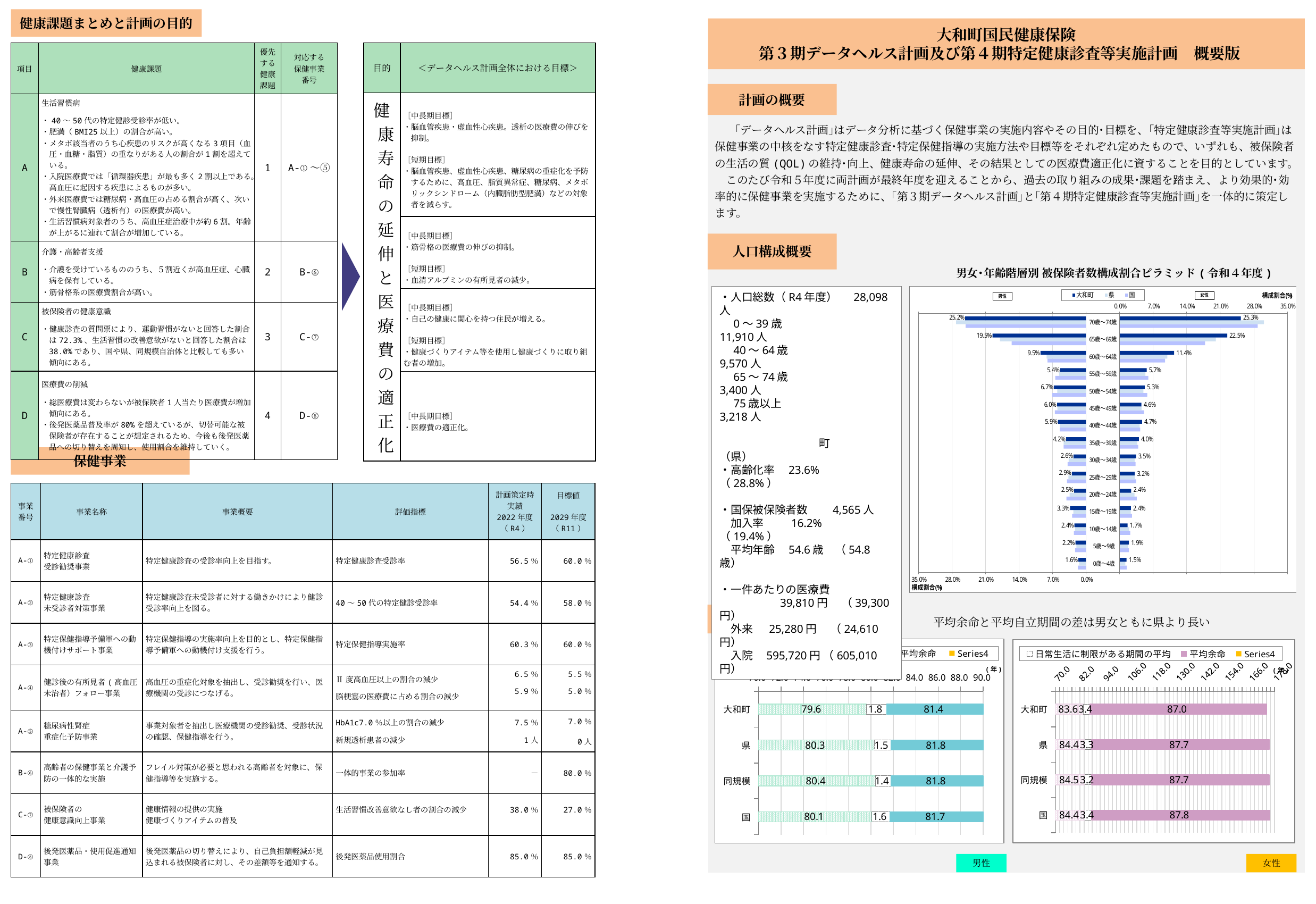
In the 男女・年齢階層別 被保険者数構成割合ピラミッド chart, what is the 大和町 value for the 70～74歳 group on the 女性 side? 25.3% In the 男女・年齢階層別 被保険者数構成割合ピラミッド chart, what is the 大和町 value for the 65～69歳 group on the 男性 side? 19.5% In the 男女・年齢階層別 被保険者数構成割合ピラミッド chart, which age group has the highest 大和町 value on the 男性 side? 70～74歳 How many age groups are shown in the 男女・年齢階層別 被保険者数構成割合ピラミッド chart? 15 In the bottom-right chart (女性), is the 平均余命 value for 県 larger or smaller than that for 大和町? larger How many series does the legend of the 男女・年齢階層別 被保険者数構成割合ピラミッド chart list? 3 In the bottom-right chart (女性), which category has the lowest 平均余命 value? 大和町 In the 男女・年齢階層別 被保険者数構成割合ピラミッド chart, which age group has the lowest 大和町 value on the 女性 side? 0歳～4歳 In the bottom-left chart (男性), what is the 平均余命 value for 大和町? 81.4 In the bottom-right chart (女性), what is the 平均余命 value for 国? 87.8 In the bottom-left chart (男性), what is the difference between the 平均余命 values for 県 and 大和町? 0.4 What kind of chart is the bottom-left chart (男性)? bar chart